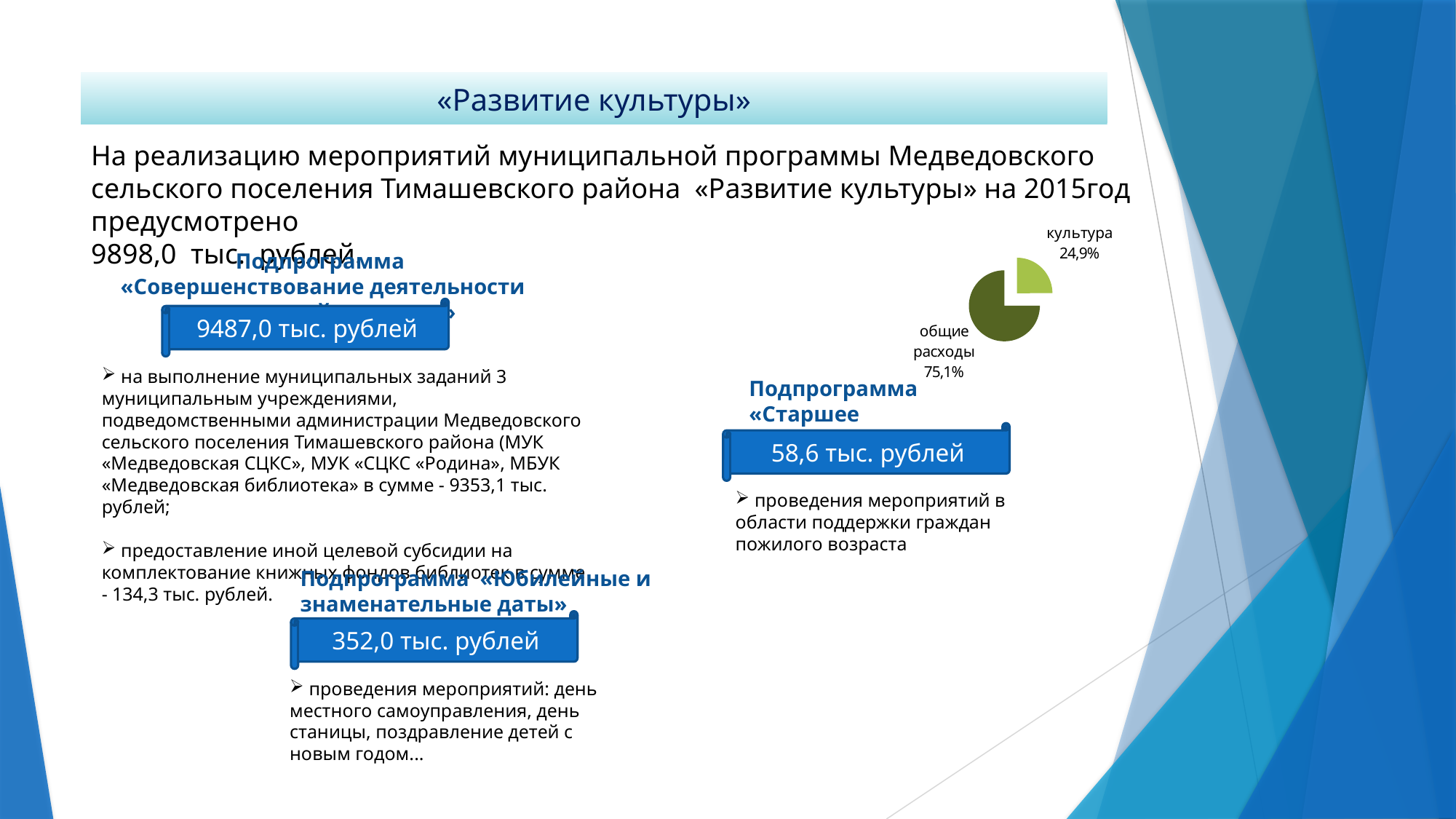
How many slices does the pie chart have? 2 Which slice of the pie chart is shown in dark green? общие расходы Which slice of the pie chart is shown in light green? культура Which slice of the pie chart is the largest? общие расходы Which slice of the pie chart is the smallest? культура What is the difference in percentage points between "общие расходы" and "культура" in the pie chart? 50,2 What kind of chart is shown on the slide? pie chart What share of the pie does "культура" represent? 24,9% What share of the pie does "общие расходы" represent? 75,1% Is the share for "культура" in the pie chart greater or less than 50%? less Which is larger in the pie chart, "культура" or "общие расходы"? общие расходы